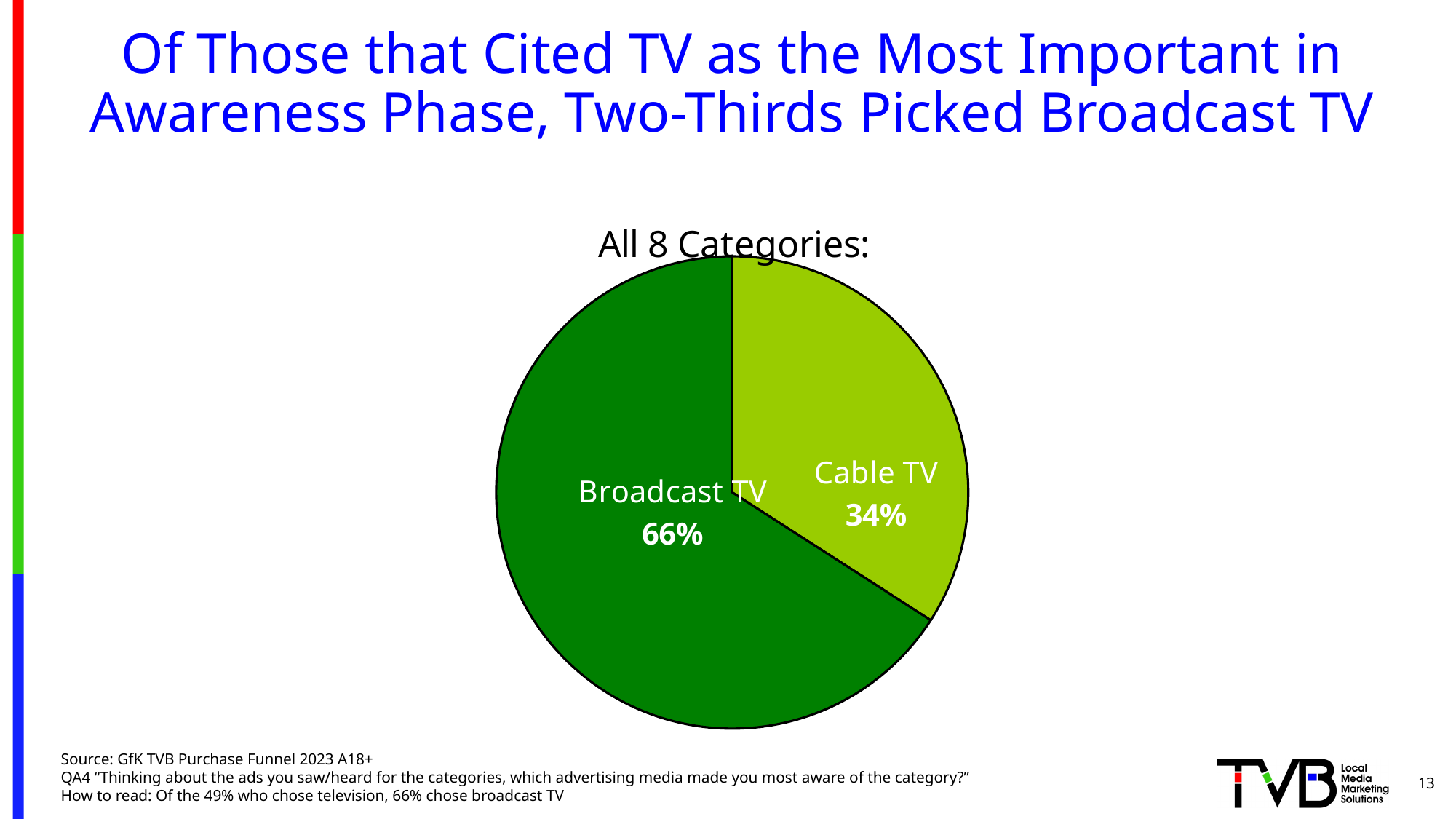
What is the difference in percentage points between Broadcast TV and Cable TV? 32 What is the title shown above the pie chart? All 8 Categories: What is the total of the two slices shown in the pie chart? 100% Which slice of the pie is the smallest? Cable TV What share of the pie does Broadcast TV have? 66% What share of the pie does Cable TV have? 34% What colour is the Cable TV slice? light green How many slices does the pie chart have? 2 What kind of chart is shown on the slide? pie chart Which slice of the pie is the largest? Broadcast TV Which is larger, the Broadcast TV slice or the Cable TV slice? Broadcast TV